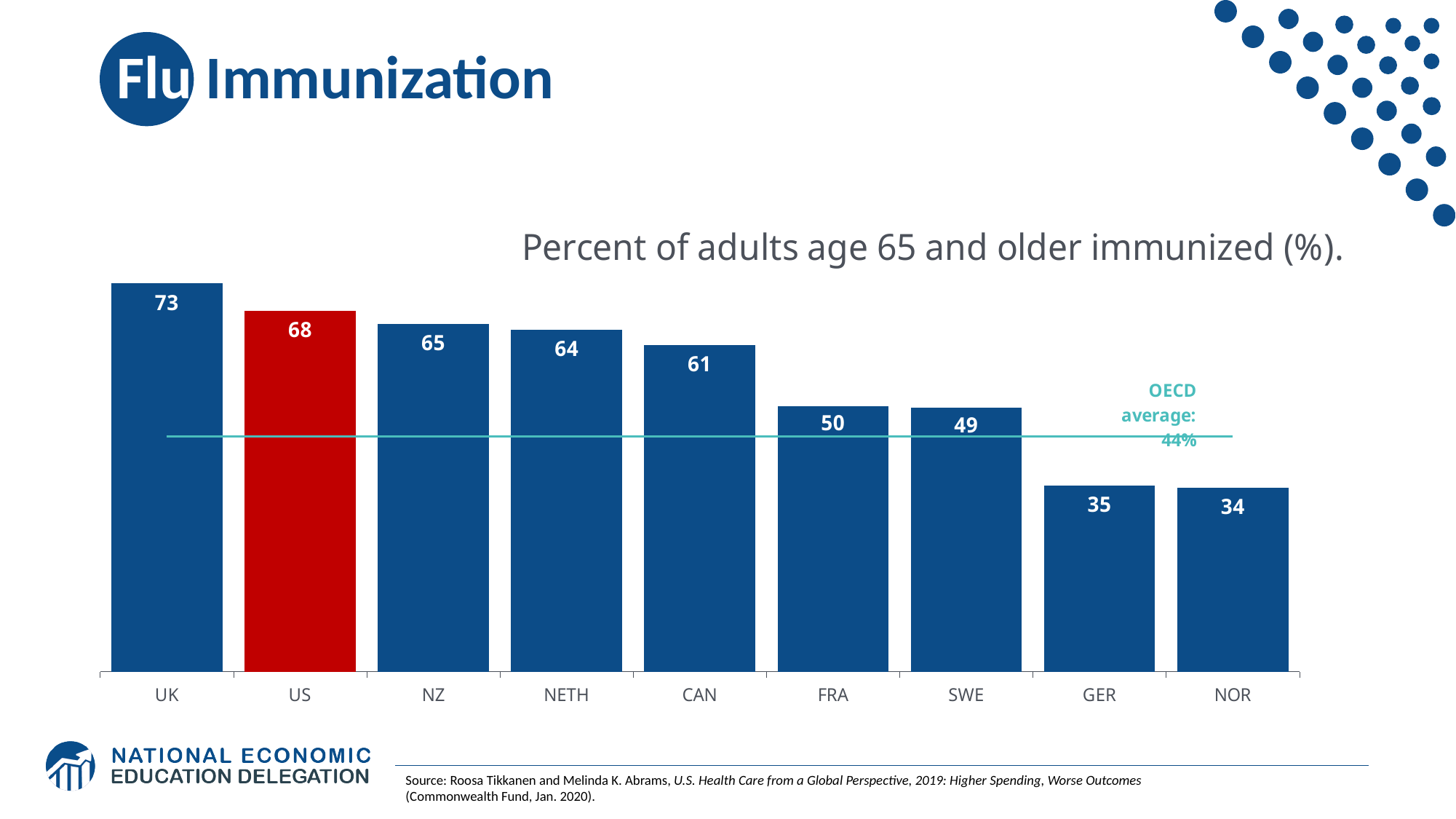
What is the difference between the values for CAN and GER? 26 Which country has the highest value? UK What kind of chart is shown on the slide? Bar chart What is the value for NETH? 64 Do the values rise or fall from left to right along the x axis? Fall Which country has the lowest value? NOR Which is larger, the value for NZ or the value for SWE? NZ How many countries are shown on the chart? 9 What is the value for FRA? 50 What is the value for the US? 68 What OECD average value is marked by the horizontal line on the chart? 44% What is the difference between the values for the UK and the US? 5